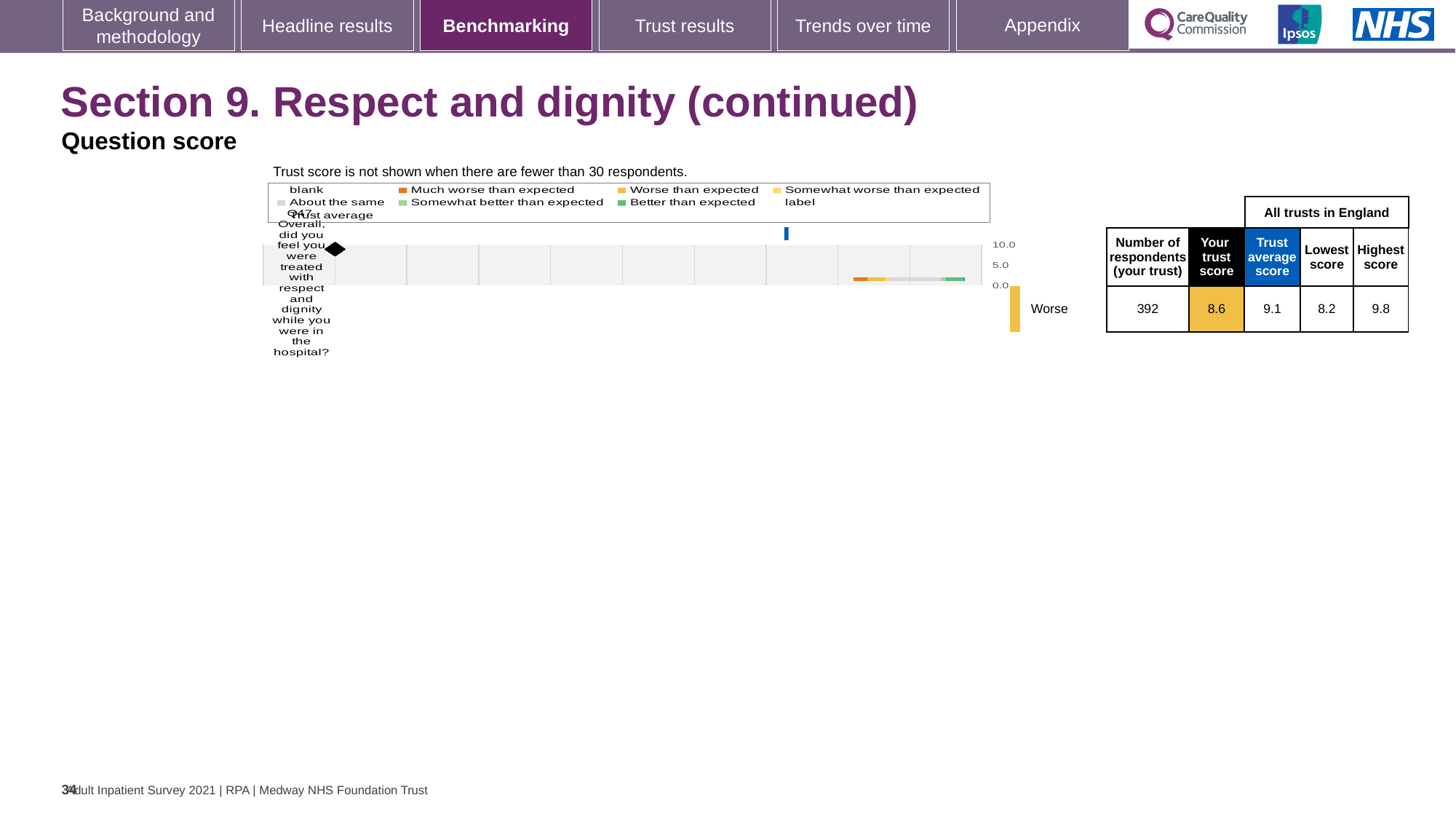
According to the table next to the chart, what is the trust score for Q47? 8.6 Is the trust score for Q47 greater or less than 5.0 on the chart's axis? greater According to the table next to the chart, what is the lowest score among all trusts in England for Q47? 8.2 How many respondents from the trust answered Q47? 392 According to the table next to the chart, what is the highest score among all trusts in England for Q47? 9.8 According to the table next to the chart, what is the trust average score for Q47? 9.1 What is the difference between the highest score and the lowest score for Q47? 1.6 Which is larger for Q47: the trust score or the trust average score? Trust average score How many survey questions are plotted on the chart? 1 Which question number is plotted on the chart? Q47 What is the highest tick value shown on the chart's score axis? 10.0 What kind of chart is shown on the slide? bar chart